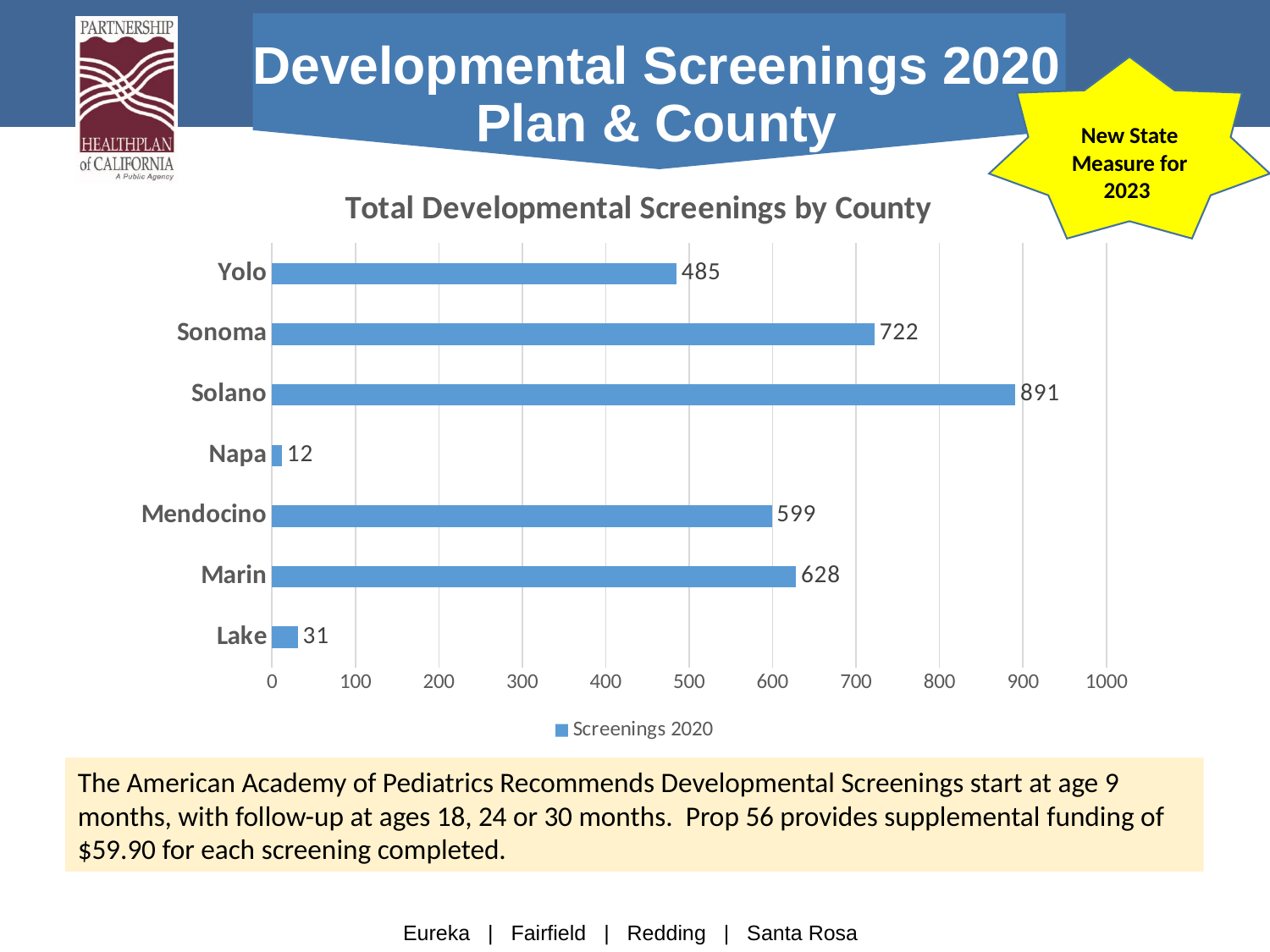
What kind of chart is shown on the slide? Bar chart What is the title of the chart? Total Developmental Screenings by County What is the difference between the values for Sonoma and Yolo? 237 Which has a larger value, Marin or Yolo? Marin What is the value for Solano in the Total Developmental Screenings by County chart? 891 Which county has the highest number of screenings? Solano What is the difference between the values for Marin and Mendocino? 29 Which county has the lowest number of screenings? Napa How many screenings are shown for Napa? 12 What is the value for Mendocino? 599 How many series does the legend list? 1 How many counties are shown in the chart? 7